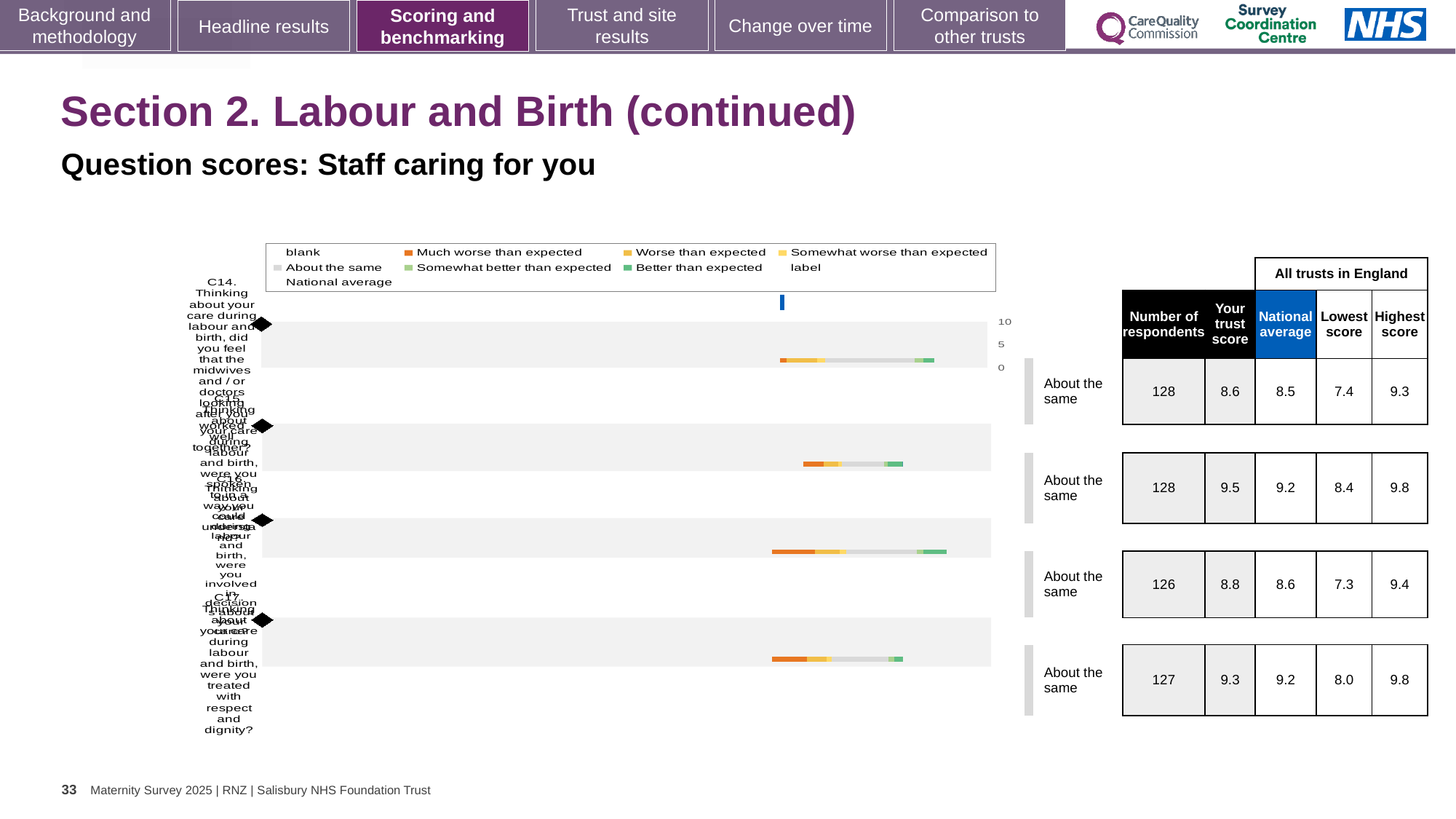
Which colour does the legend use for 'Much worse than expected'? orange What benchmark category is shown for all four questions on the slide? About the same Which colour does the legend use for 'Better than expected'? green What is the trust score for C17 (treated with respect and dignity)? 9.3 How many respondents answered C17 (treated with respect and dignity)? 127 What kind of chart is shown on the slide? bar chart What is the national average for C14 (midwives and/or doctors worked well together)? 8.5 What is the difference between the trust score and the national average for C17 (treated with respect and dignity)? 0.1 Is the trust score for C14 higher or lower than the national average for C14? higher How many questions (categories) are plotted in the chart? 4 What is the trust score for C14 (midwives and/or doctors worked well together)? 8.6